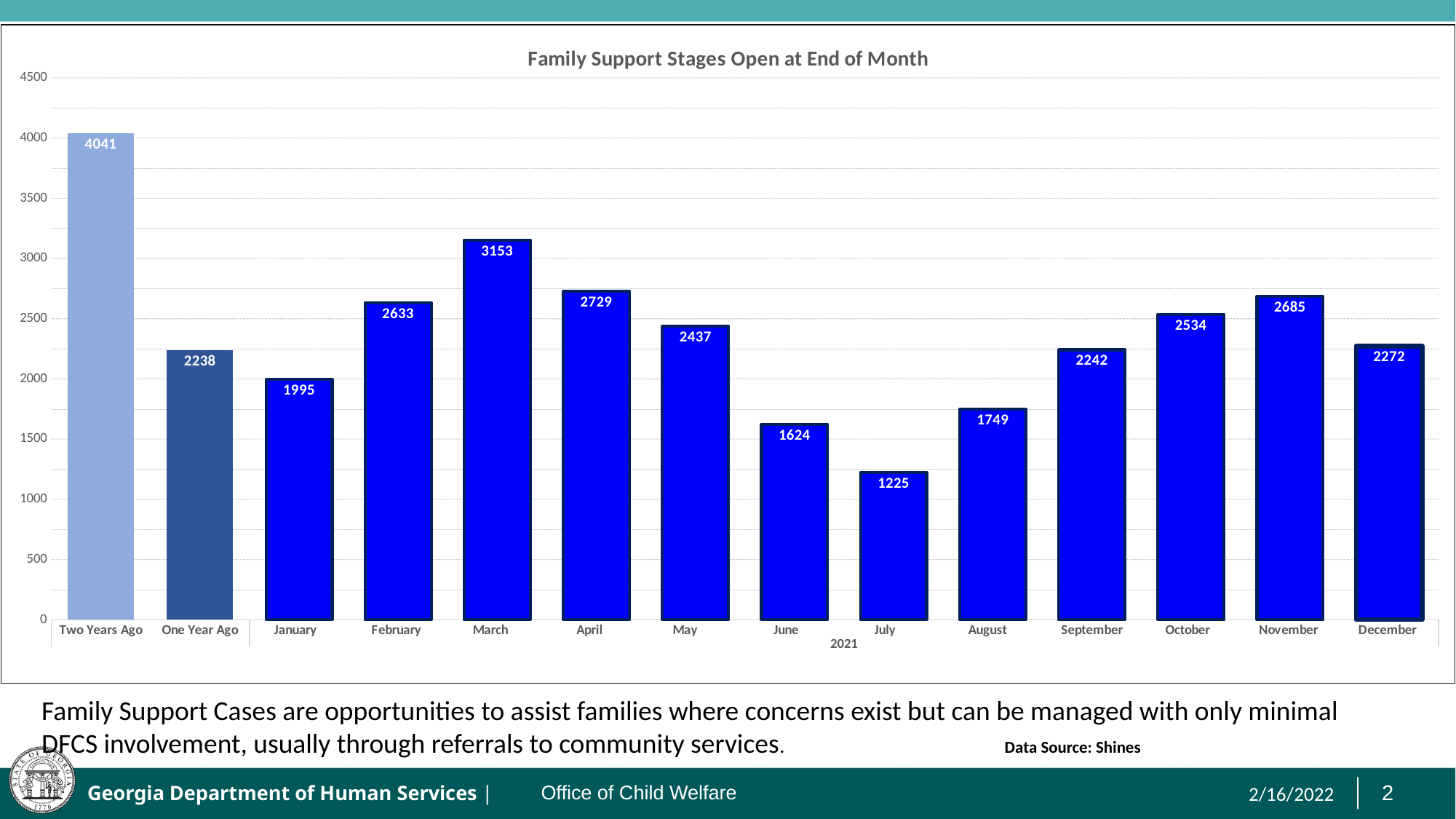
Which of the 2021 months has the highest value? March What kind of chart is shown on the slide? Bar chart Which category has the lowest value? July What is the value for July? 1225 What is the difference between the values for March and July? 1928 What is the value for March in the Family Support Stages Open at End of Month chart? 3153 Which is larger, the value for November or the value for February? November How many bars are shown in the chart? 14 Which category has the highest value? Two Years Ago What is the title of the chart? Family Support Stages Open at End of Month What is the value for Two Years Ago? 4041 What is the difference between the values for Two Years Ago and One Year Ago? 1803